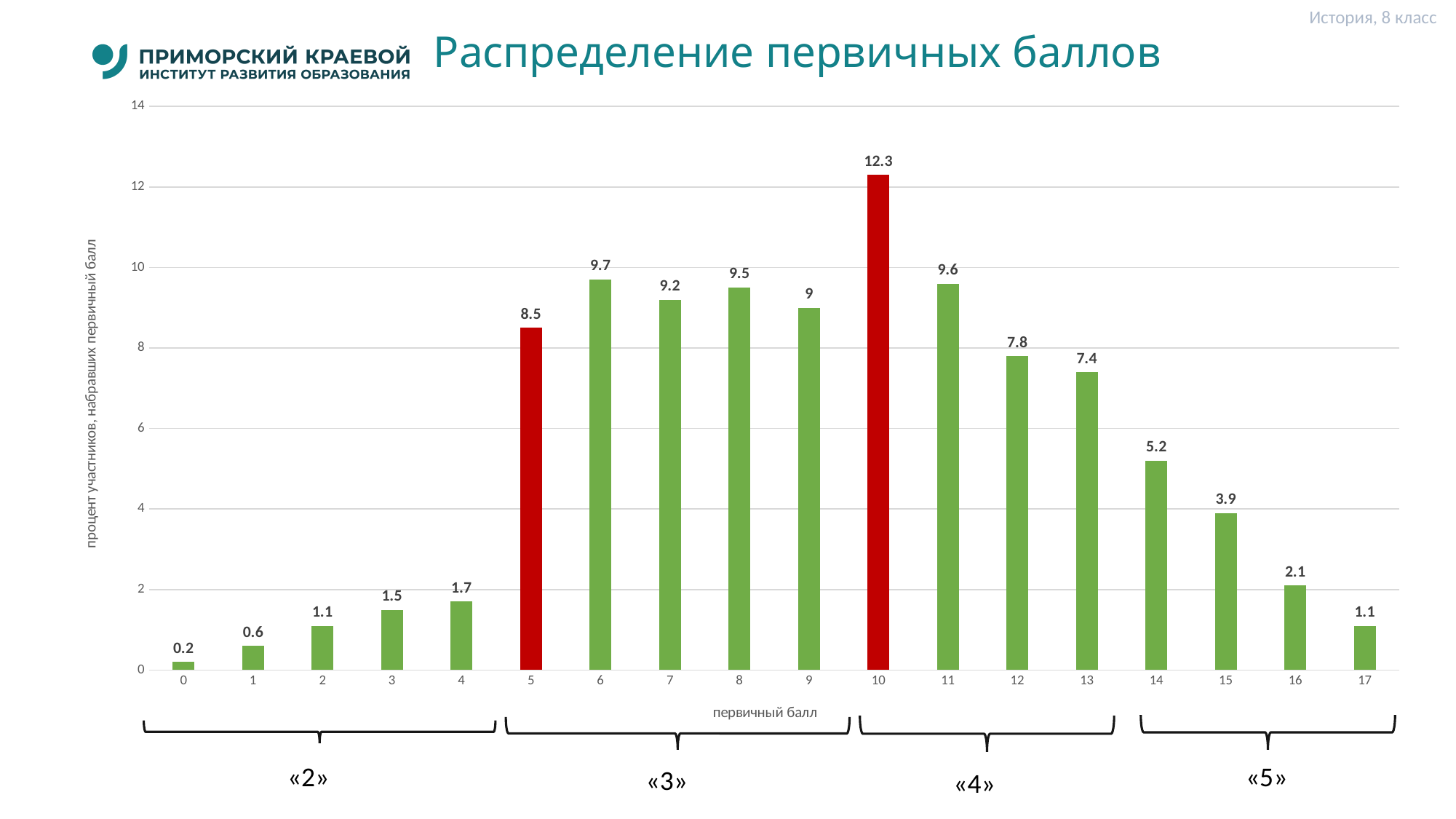
What is the value shown for primary score 14? 5.2 What percentage of participants scored a primary score of 10? 12.3 Which primary score has the lowest percentage of participants? 0 Do the values rise or fall from primary score 10 to primary score 17? fall Which has a larger value: primary score 12 or primary score 15? 12 How many primary score categories are shown on the x axis? 18 What is the difference between the values for primary scores 10 and 6? 2.6 What is the value shown for primary score 5? 8.5 Which primary score has the highest percentage of participants? 10 What kind of chart is shown on the slide? bar chart Is the value for primary score 13 greater or less than 8? less Which two primary scores are shown with red bars? 5 and 10